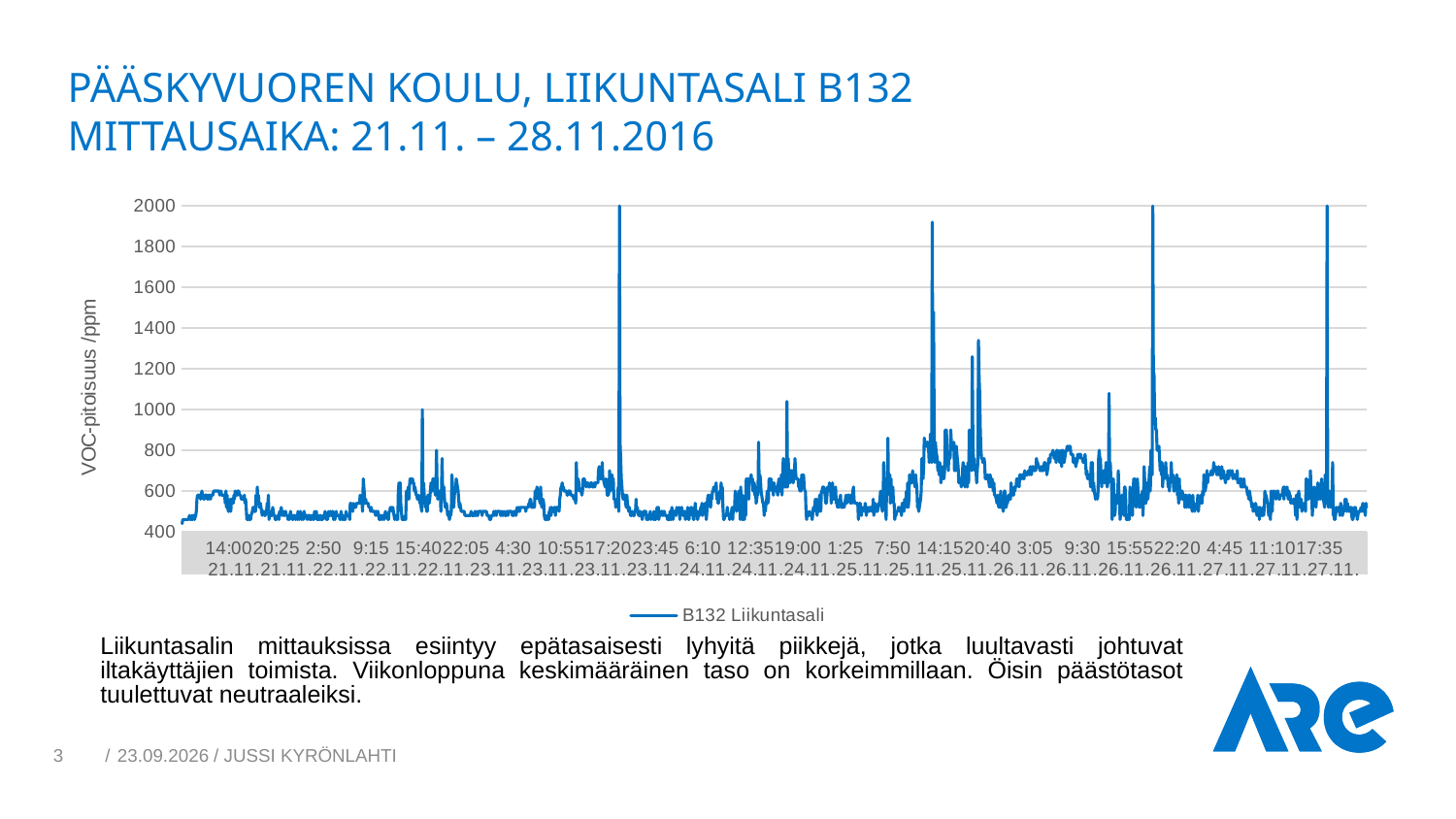
Is the value around 4:30 on 23.11. greater or less than 1000? less Is the value at the start of the measurement (14:00 on 21.11.) greater or less than 600? less Is the peak value around 17:20 on 23.11. greater or less than 1800? greater What kind of chart is shown on the slide? line chart How many series does the chart legend list? 1 What is the name of the series shown in the chart legend? B132 Liikuntasali What is the label on the vertical axis of the chart? VOC-pitoisuus /ppm